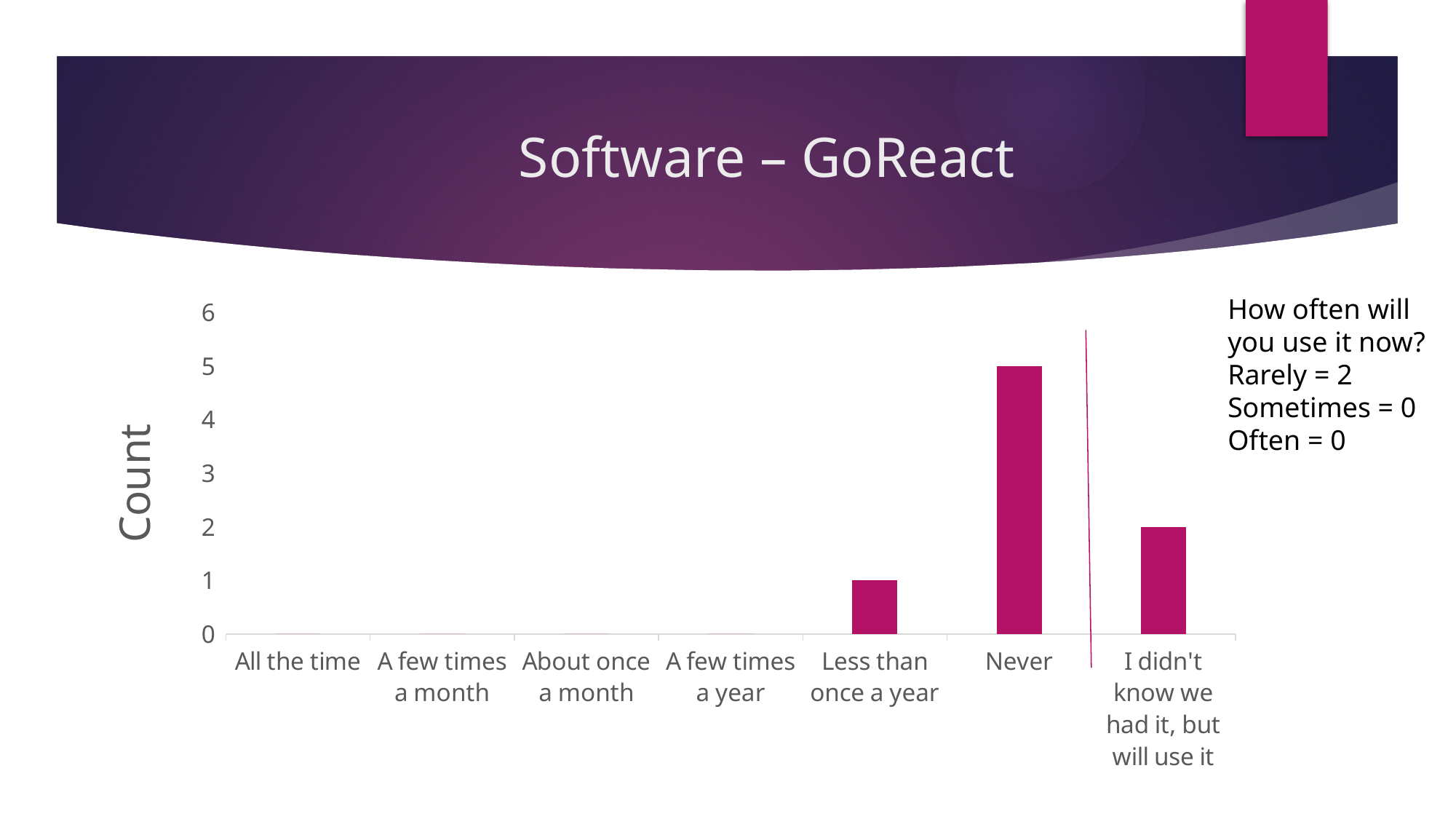
What is the label on the vertical axis of the chart? Count Which is larger, the count for "Less than once a year" or the count for "I didn't know we had it, but will use it"? I didn't know we had it, but will use it How many categories are shown on the x axis of the chart? 7 What is the count for "Less than once a year"? 1 What kind of chart is shown on the slide? bar chart What is the count for "I didn't know we had it, but will use it"? 2 Which category has the highest count? Never What is the count for "All the time"? 0 What is the title of the slide containing the chart? Software – GoReact What is the count for "Never"? 5 What is the difference between the count for "Never" and the count for "I didn't know we had it, but will use it"? 3 Is the count for "Never" greater or less than 4? greater